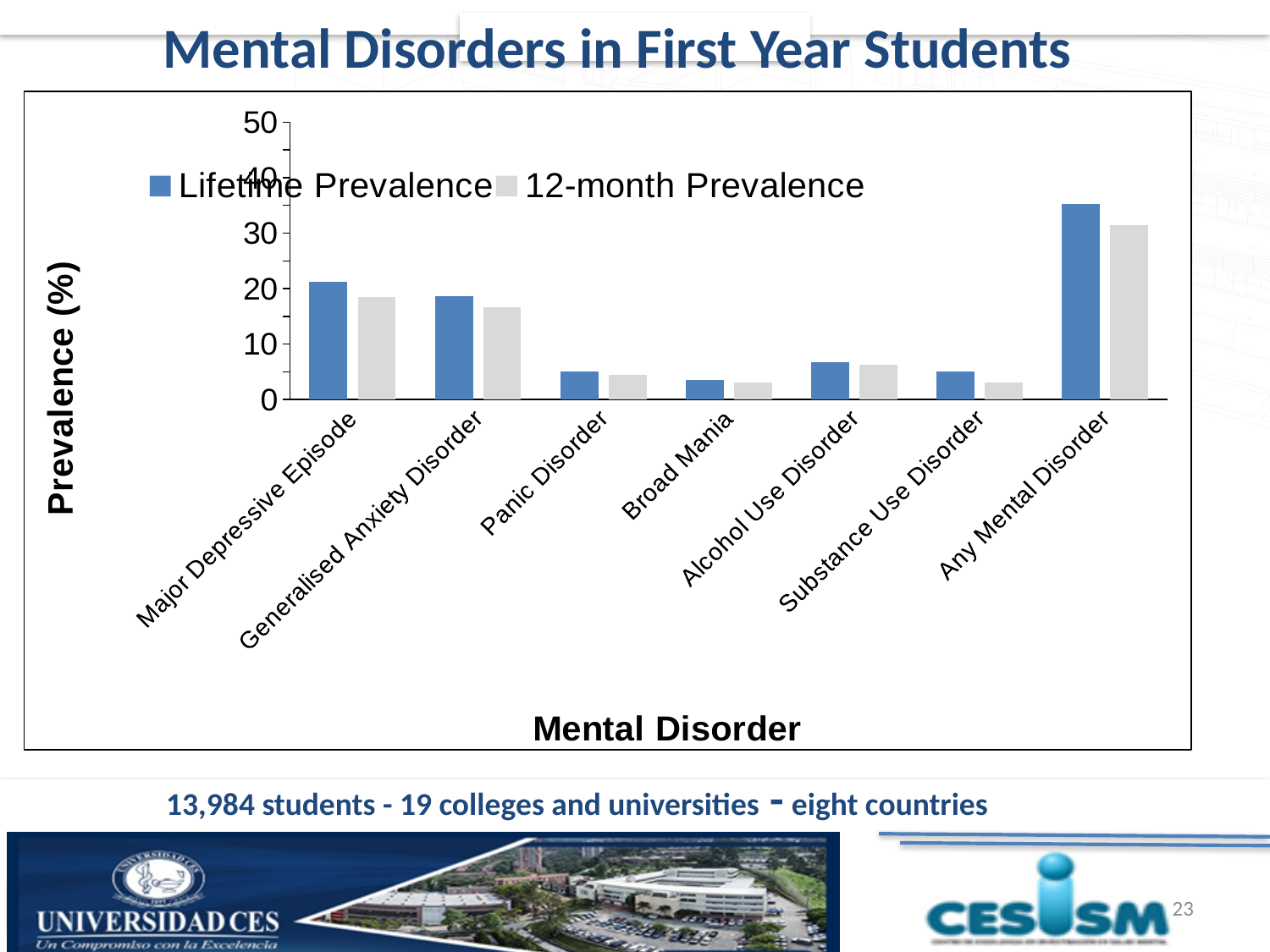
What is the title of the vertical axis? Prevalence (%) Is the Lifetime Prevalence for Any Mental Disorder greater or less than 30? greater Which mental disorder has the highest 12-month Prevalence? Any Mental Disorder Which has a higher Lifetime Prevalence, Major Depressive Episode or Generalised Anxiety Disorder? Major Depressive Episode Which has a higher Lifetime Prevalence, Alcohol Use Disorder or Panic Disorder? Alcohol Use Disorder How many series does the legend list? 2 Is the 12-month Prevalence for Broad Mania greater or less than 10? less Which mental disorder has the lowest Lifetime Prevalence? Broad Mania Is the Lifetime Prevalence for Major Depressive Episode greater or less than 10? greater Which mental disorder has the highest Lifetime Prevalence? Any Mental Disorder What kind of chart is shown on the slide? Bar chart How many mental disorder categories are shown on the x axis? 7